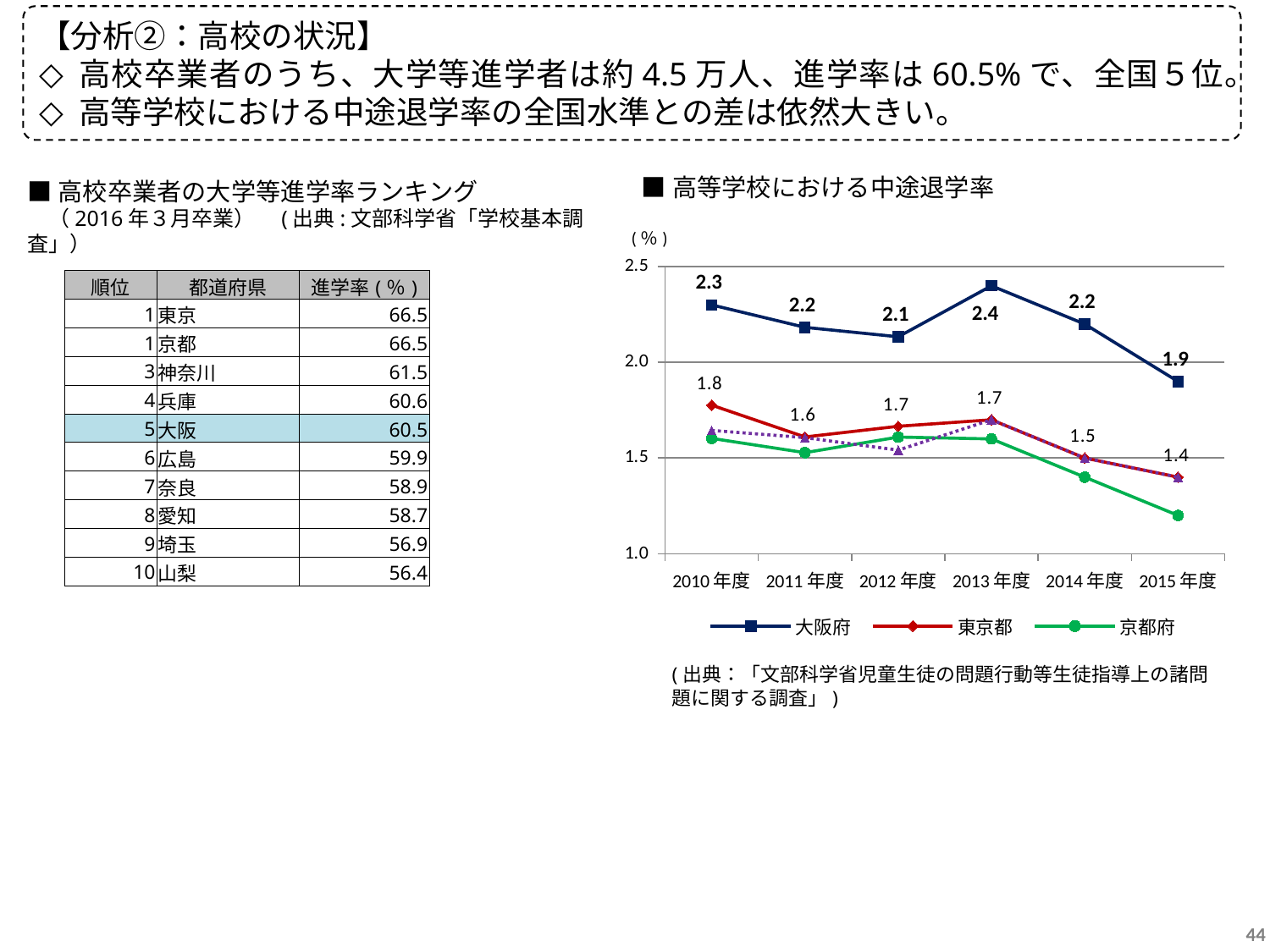
In the 高等学校における中途退学率 chart, in which year is the value for 大阪府 lowest? 2015年度 How many years are plotted on the x axis of the 高等学校における中途退学率 chart? 6 In the 高等学校における中途退学率 chart, what is the value for 東京都 in 2010年度? 1.8 In the 高等学校における中途退学率 chart, in which year is the value for 大阪府 highest? 2013年度 How many series does the legend of the 高等学校における中途退学率 chart list? 3 In the 高等学校における中途退学率 chart, which is larger in 2013年度, 大阪府 or 東京都? 大阪府 In the 高等学校における中途退学率 chart, does the value for 大阪府 rise or fall from 2013年度 to 2015年度? fall What kind of chart is the 高等学校における中途退学率 chart? line chart In the 高等学校における中途退学率 chart, what is the difference between the 大阪府 values for 2010年度 and 2015年度? 0.4 In the 高等学校における中途退学率 chart, what is the value for 大阪府 in 2015年度? 1.9 In the 高等学校における中途退学率 chart, what is the value for 大阪府 in 2013年度? 2.4 In the 高等学校における中途退学率 chart, is the value for 京都府 in 2015年度 greater or less than 1.5? less